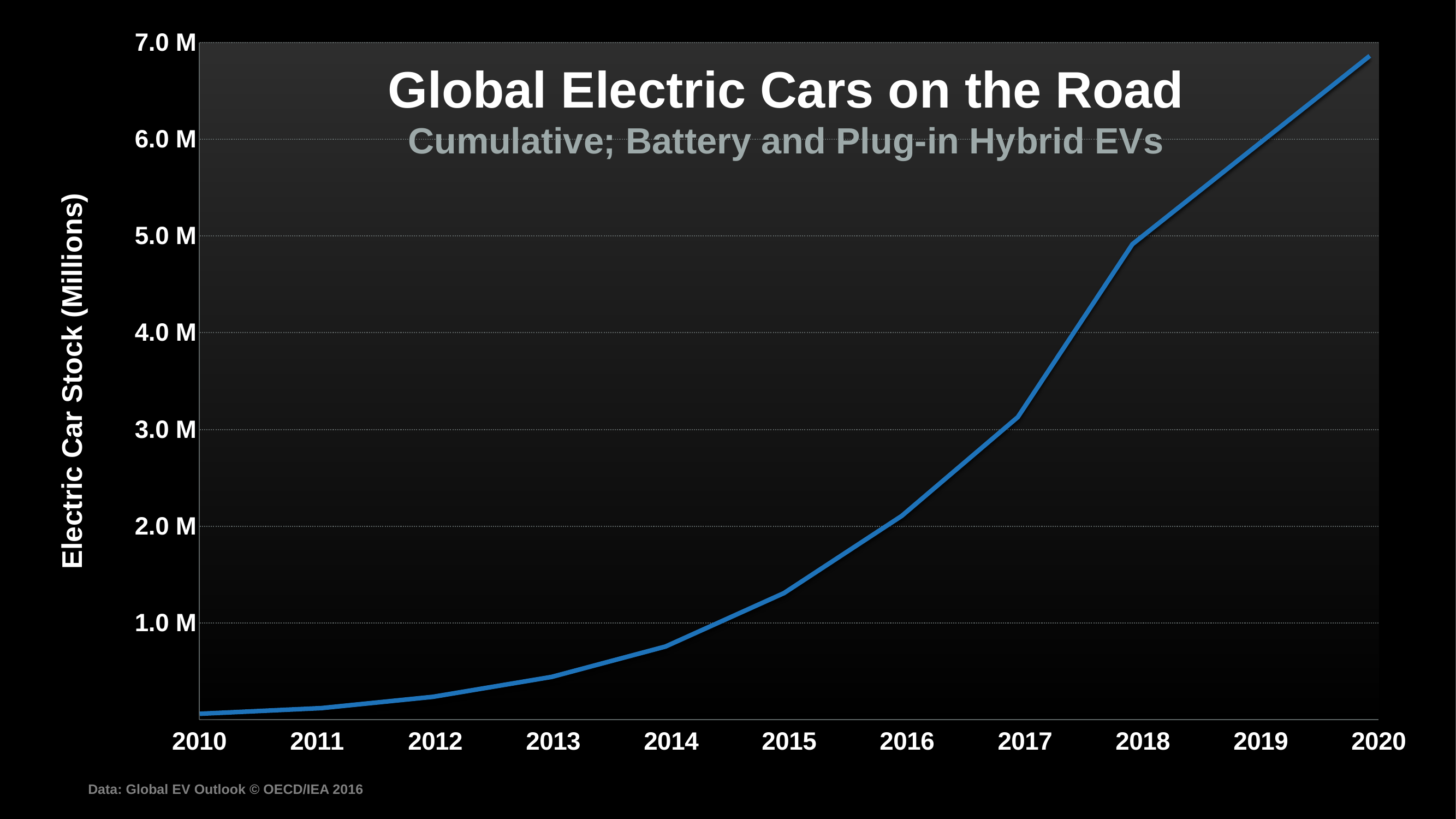
What kind of chart is shown on the slide? line chart Is the value for 2016 greater or less than 3.0 M? less What is the title of the chart? Global Electric Cars on the Road Is the value for 2014 greater or less than 1.0 M? less Do the values rise or fall from 2010 to 2020? rise Which is larger, the value for 2018 or the value for 2016? 2018 How many years are shown along the x axis? 11 Which year has the lowest electric car stock? 2010 Is the value for 2020 greater or less than 6.0 M? greater Which year has the highest electric car stock? 2020 What is the label on the vertical axis? Electric Car Stock (Millions)